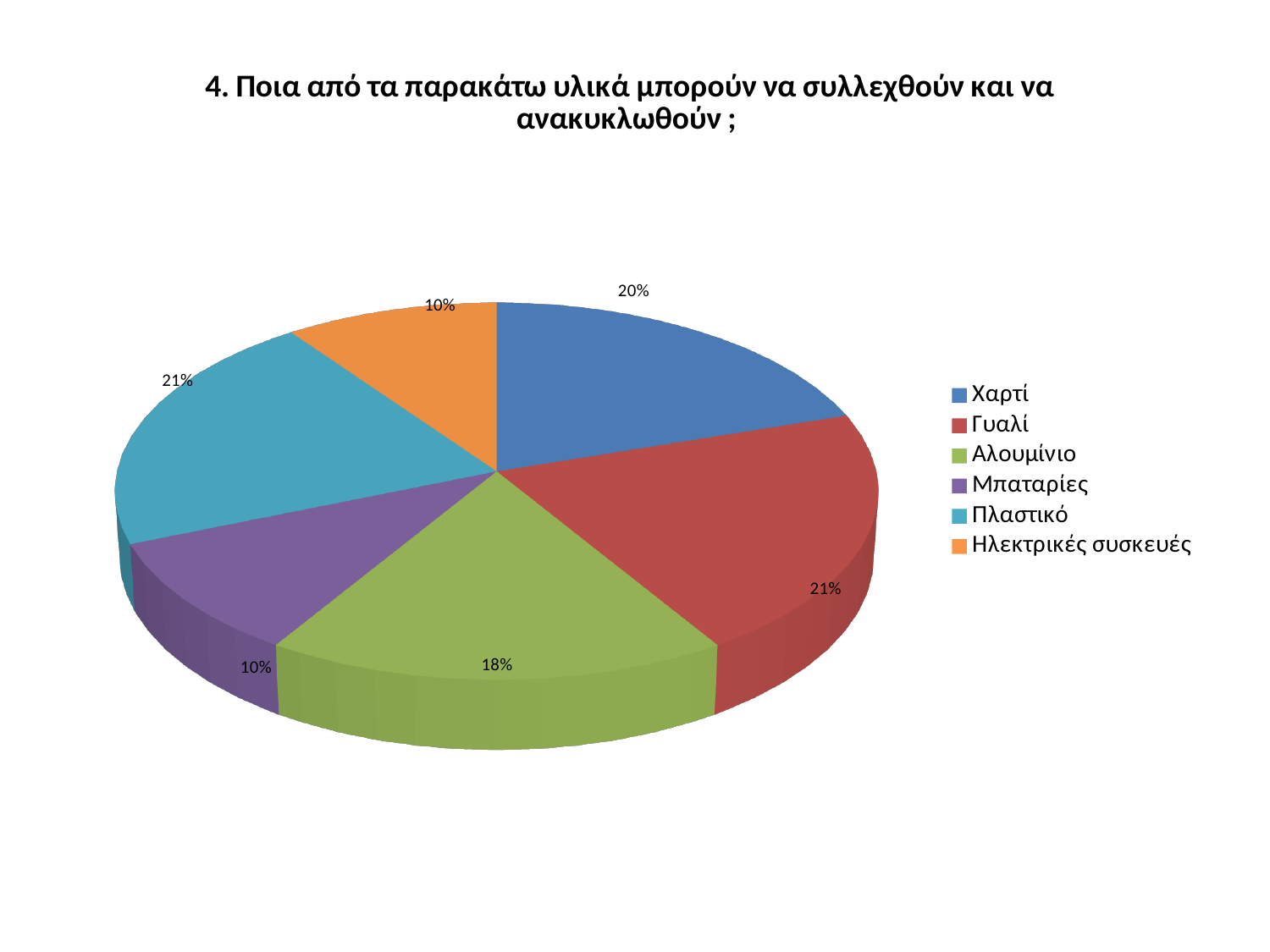
What is the difference in percentage points between the share for Χαρτί and the share for Μπαταρίες? 10 What is the share of the pie for Γυαλί? 21% What kind of chart is shown on the slide? Pie chart Which is larger, the share for Χαρτί or the share for Αλουμίνιο? Χαρτί How many entries does the legend list? 6 What percentage of the pie does Αλουμίνιο represent? 18% What percentage of the pie does Πλαστικό represent? 21% What percentage of the pie does Χαρτί represent? 20% How many slices does the pie chart have? 6 What percentage of the pie does Μπαταρίες represent? 10% What percentage of the pie does Ηλεκτρικές συσκευές represent? 10% Which legend entry is shown in orange? Ηλεκτρικές συσκευές